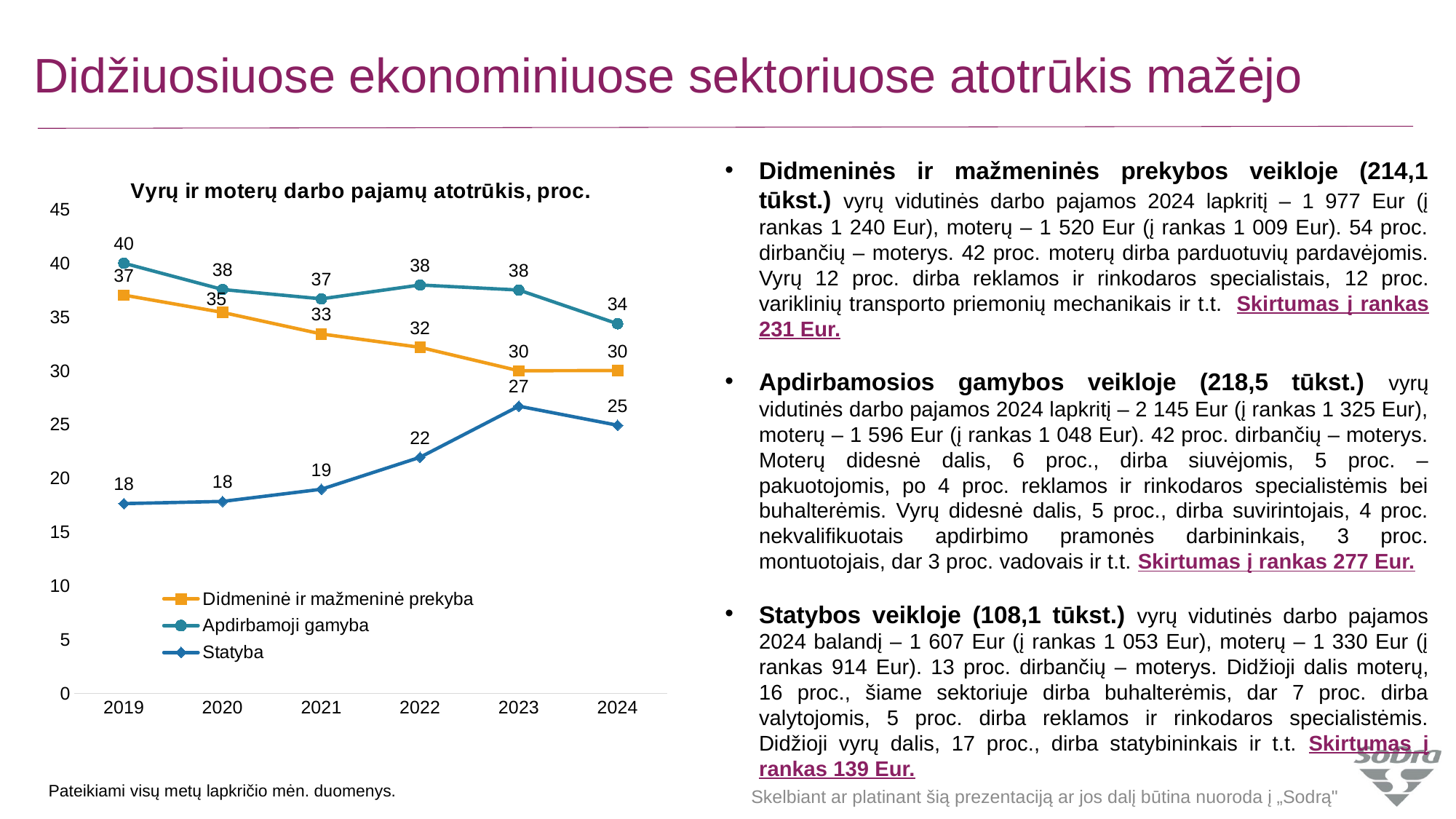
Does the value for Didmeninė ir mažmeninė prekyba rise or fall from 2019 to 2024? fall How many years are shown on the x axis? 6 What type of chart is shown on the slide? line chart How many series does the legend list? 3 What is the value for Didmeninė ir mažmeninė prekyba in 2022? 32 In which year is the value for Statyba highest? 2023 What is the value for Statyba in 2023? 27 In which year is the value for Didmeninė ir mažmeninė prekyba lowest? 2023 and 2024 What is the difference between Apdirbamoji gamyba and Statyba in 2024? 9 Which is larger in 2021: Apdirbamoji gamyba or Didmeninė ir mažmeninė prekyba? Apdirbamoji gamyba What is the value for Apdirbamoji gamyba in 2019? 40 What is the title of the chart? Vyrų ir moterų darbo pajamų atotrūkis, proc.